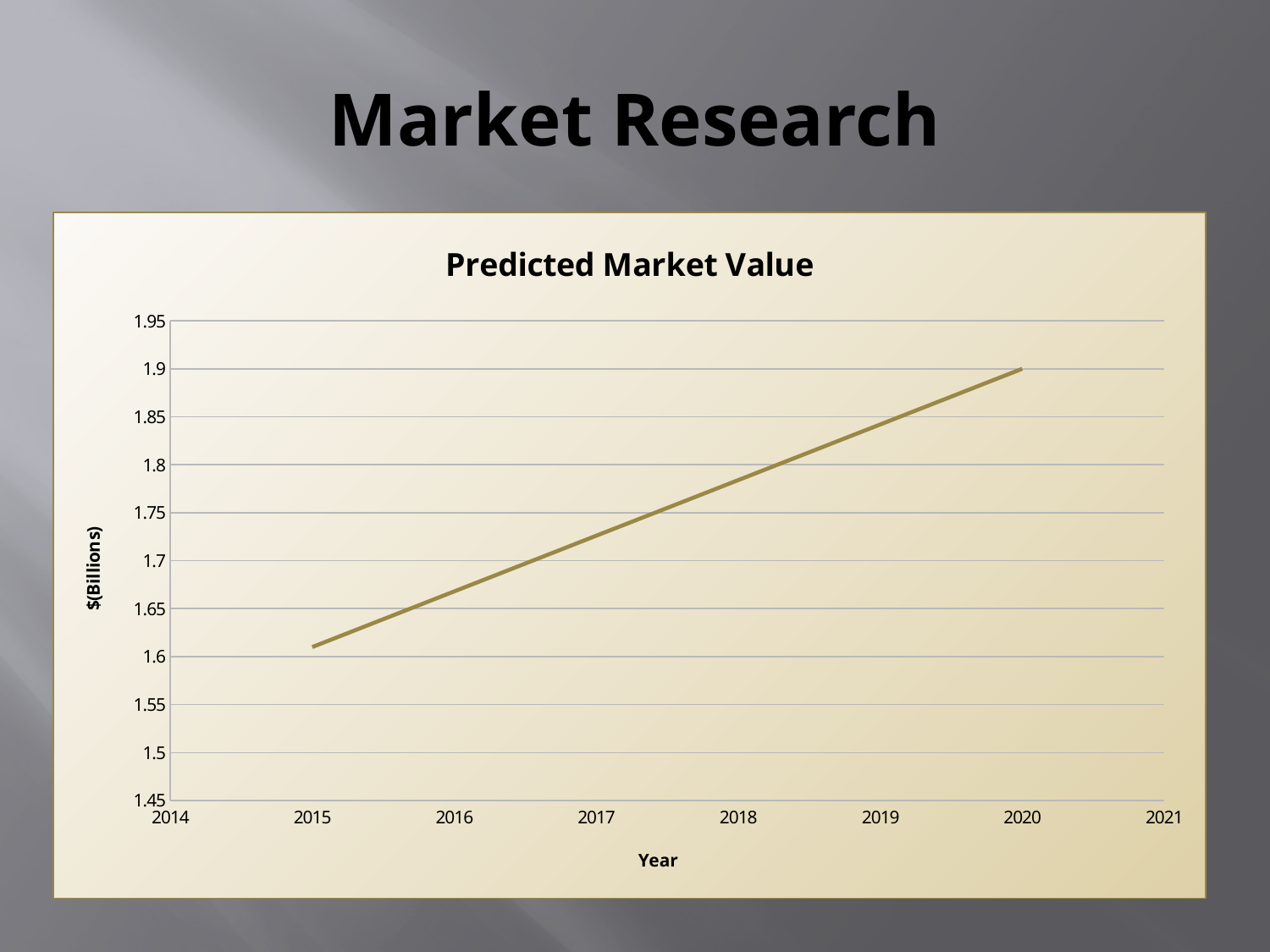
Is the predicted market value for 2017 greater or less than 1.8? less Is the predicted market value for 2018 greater or less than 1.7? greater Which year has the larger predicted market value, 2016 or 2018? 2018 What kind of chart is shown on the slide? line chart What is the predicted market value for 2020? 1.9 Which year has the highest predicted market value? 2020 What is the label on the vertical axis of the chart? $(Billions) Is the predicted market value for 2015 greater or less than 1.55? greater Which year has the lowest predicted market value? 2015 Does the predicted market value rise or fall from 2015 to 2020? rise What is the title of the chart? Predicted Market Value